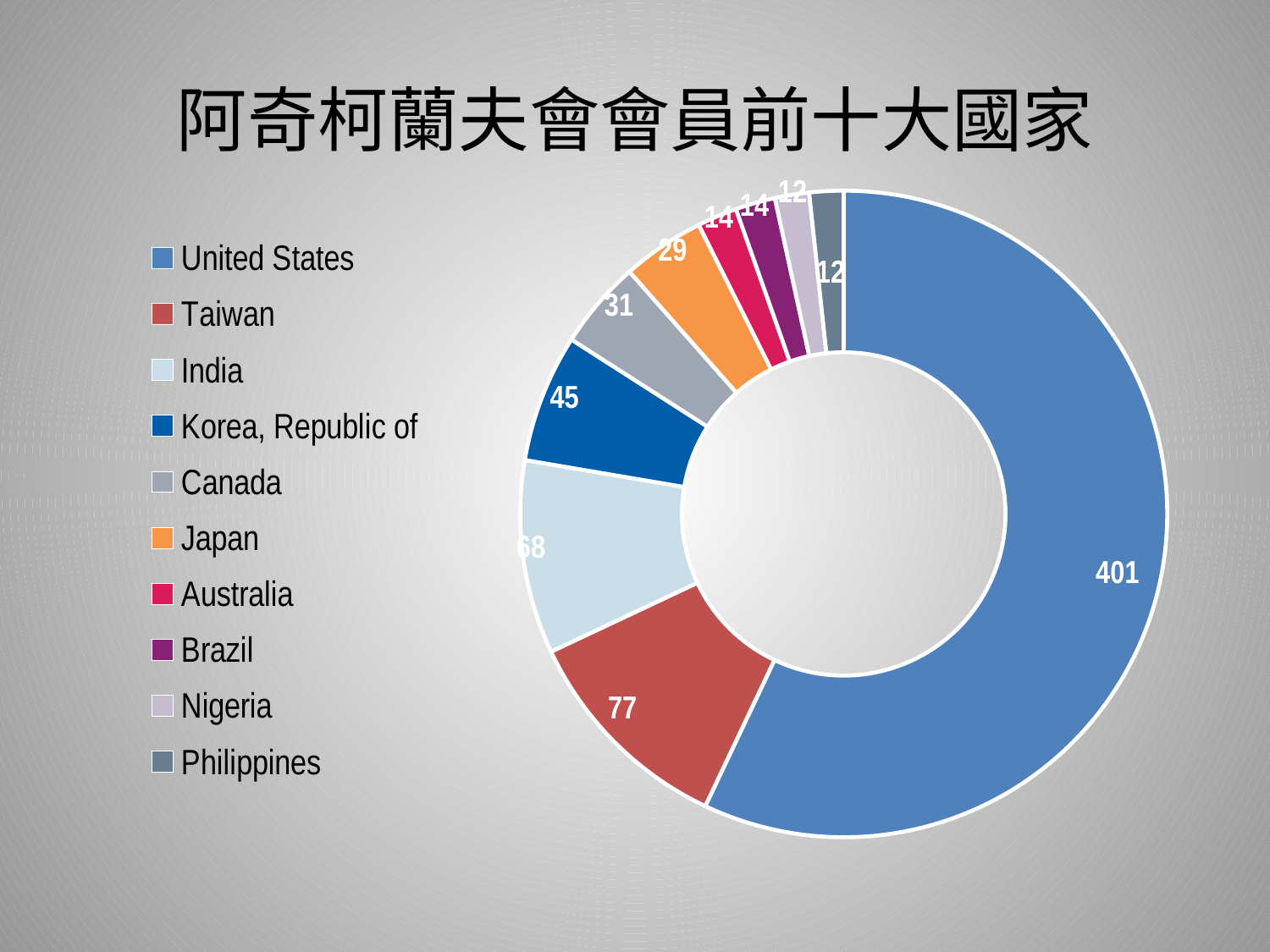
What is the value for Korea, Republic of? 45 What type of chart is shown on the slide? Doughnut (pie) chart What is the value for United States? 401 Which country has the largest slice? United States What is the total of all the values in the chart? 703 Which country is listed last in the legend? Philippines What is the value for Japan? 29 Which is larger, the value for Canada or the value for Japan? Canada What is the value for Taiwan? 77 How many countries are shown in the chart? 10 What is the difference between the values for United States and Taiwan? 324 What is the difference between the values for Taiwan and India? 9